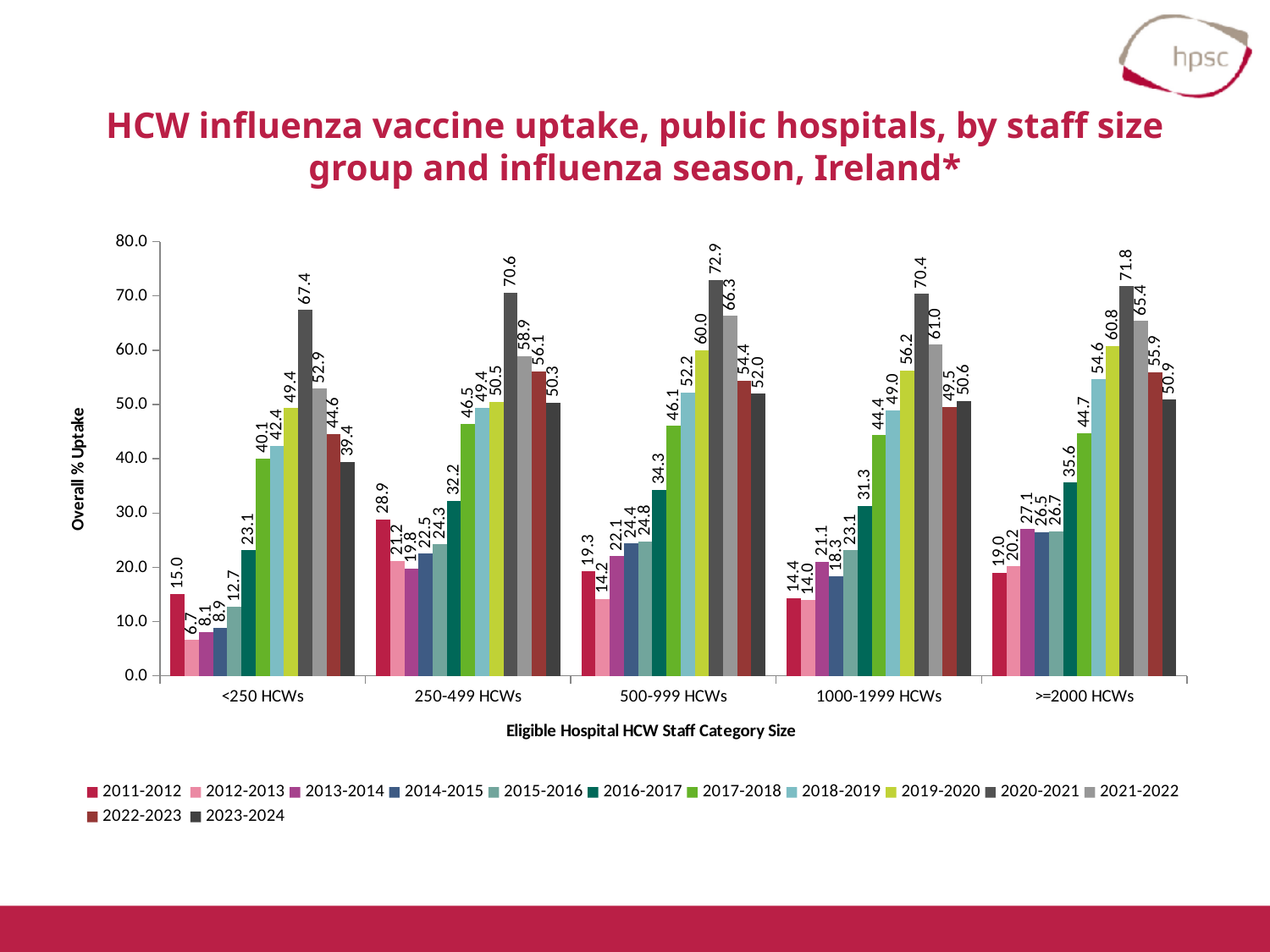
Within the 1000-1999 HCWs group, do the values rise or fall from 2016-2017 to 2020-2021? Rise What kind of chart is shown on the slide? Bar chart Which influenza season has the lowest value in the <250 HCWs group? 2012-2013 Which is larger for the 250-499 HCWs group: the 2022-2023 value or the 2023-2024 value? 2022-2023 Which staff size group has the highest 2020-2021 value? 500-999 HCWs How many influenza seasons does the legend list? 13 What is the difference between the 2020-2021 and 2021-2022 values for the <250 HCWs group? 14.5 What is the 2023-2024 value for the >=2000 HCWs group? 50.9 What is the 2011-2012 value for the <250 HCWs group? 15.0 What is the label of the y axis? Overall % Uptake What is the 2020-2021 value for the 500-999 HCWs group? 72.9 How many staff size groups are shown on the x axis? 5